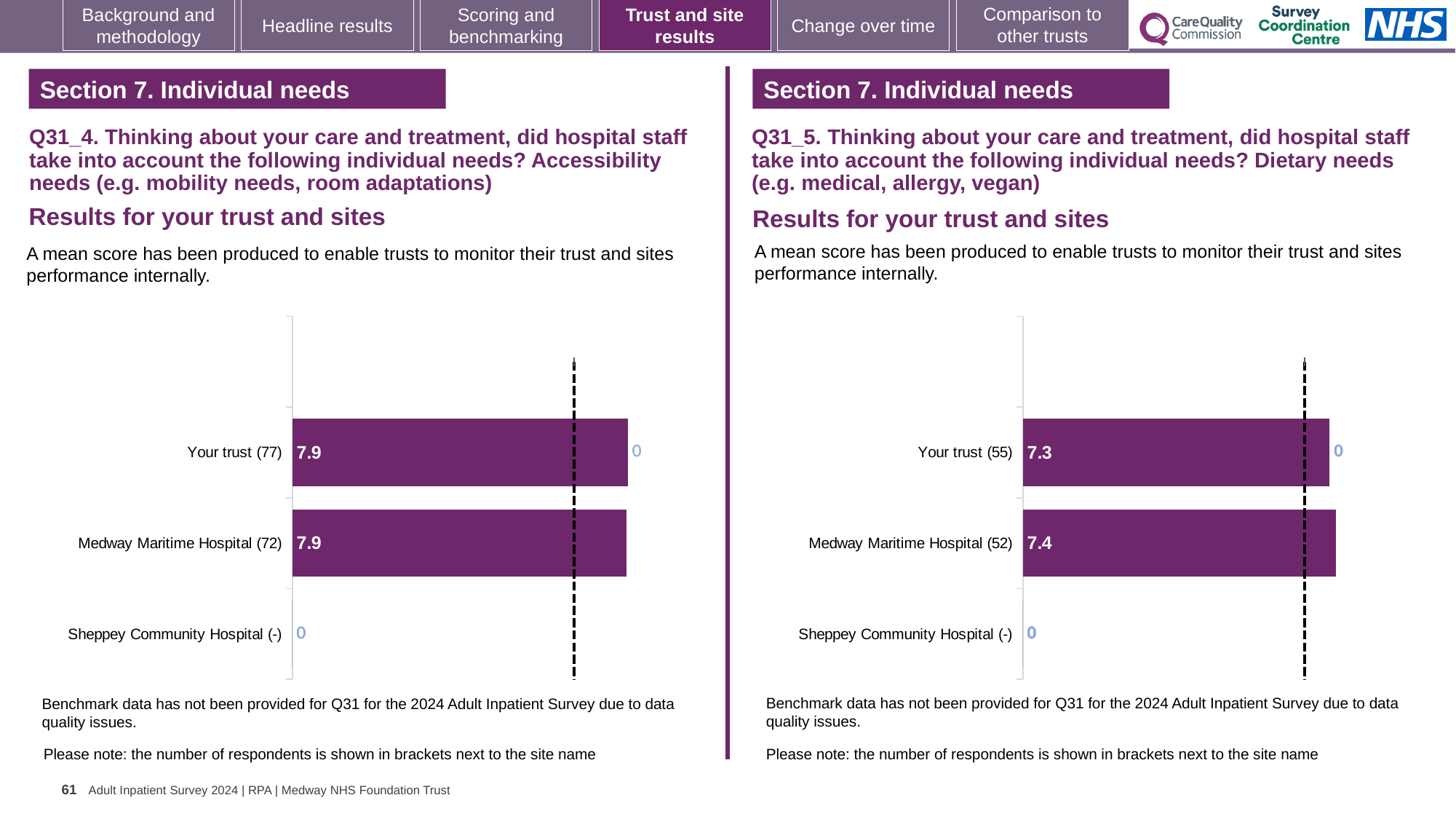
In the Q31_5 Dietary needs chart on the right, what is the mean score for Your trust? 7.3 In the Q31_4 Accessibility needs chart on the left, what is the mean score for Medway Maritime Hospital? 7.9 In the Q31_5 Dietary needs chart on the right, what is the difference between the mean scores for Medway Maritime Hospital and Your trust? 0.1 In the Q31_5 Dietary needs chart on the right, how many respondents are shown in brackets for Medway Maritime Hospital? 52 In the Q31_5 Dietary needs chart on the right, what value is shown for Sheppey Community Hospital? 0 In the Q31_5 Dietary needs chart on the right, what is the mean score for Medway Maritime Hospital? 7.4 In the Q31_4 Accessibility needs chart on the left, is the mean score for Your trust the same as the mean score for Medway Maritime Hospital? Yes In the Q31_4 Accessibility needs chart on the left, what is the mean score for Your trust? 7.9 In the Q31_5 Dietary needs chart on the right, which has the higher mean score, Your trust or Medway Maritime Hospital? Medway Maritime Hospital In the Q31_4 Accessibility needs chart on the left, how many categories are listed on the vertical axis? 3 In the Q31_4 Accessibility needs chart on the left, how many respondents are shown in brackets for Your trust? 77 What type of chart is used in the Q31_5 Dietary needs chart on the right? Bar chart